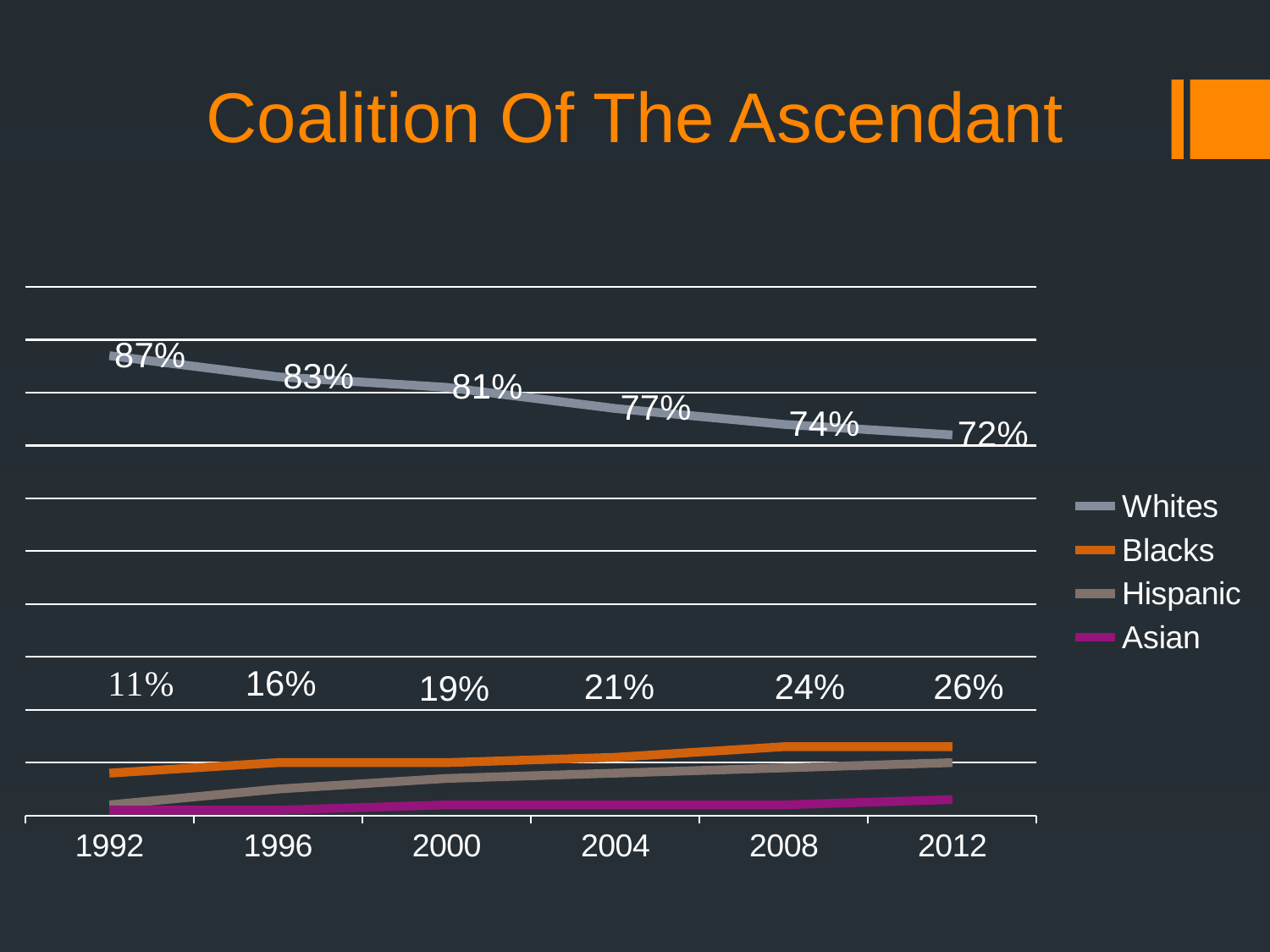
In which year is the Whites value lowest? 2012 Does the Whites line rise or fall from 1992 to 2012? fall How many series does the legend list? 4 What is the value for Whites in 2004? 77% What is the value for Whites in 2012? 72% What is the difference between the Whites value in 1992 and in 2012? 15% Which series has the highest values across all years? Whites In which year is the Whites value highest? 1992 How many years are shown along the x axis? 6 What kind of chart is shown on the slide? line chart What is the value for Whites in 1992? 87% What is the title of the slide? Coalition Of The Ascendant